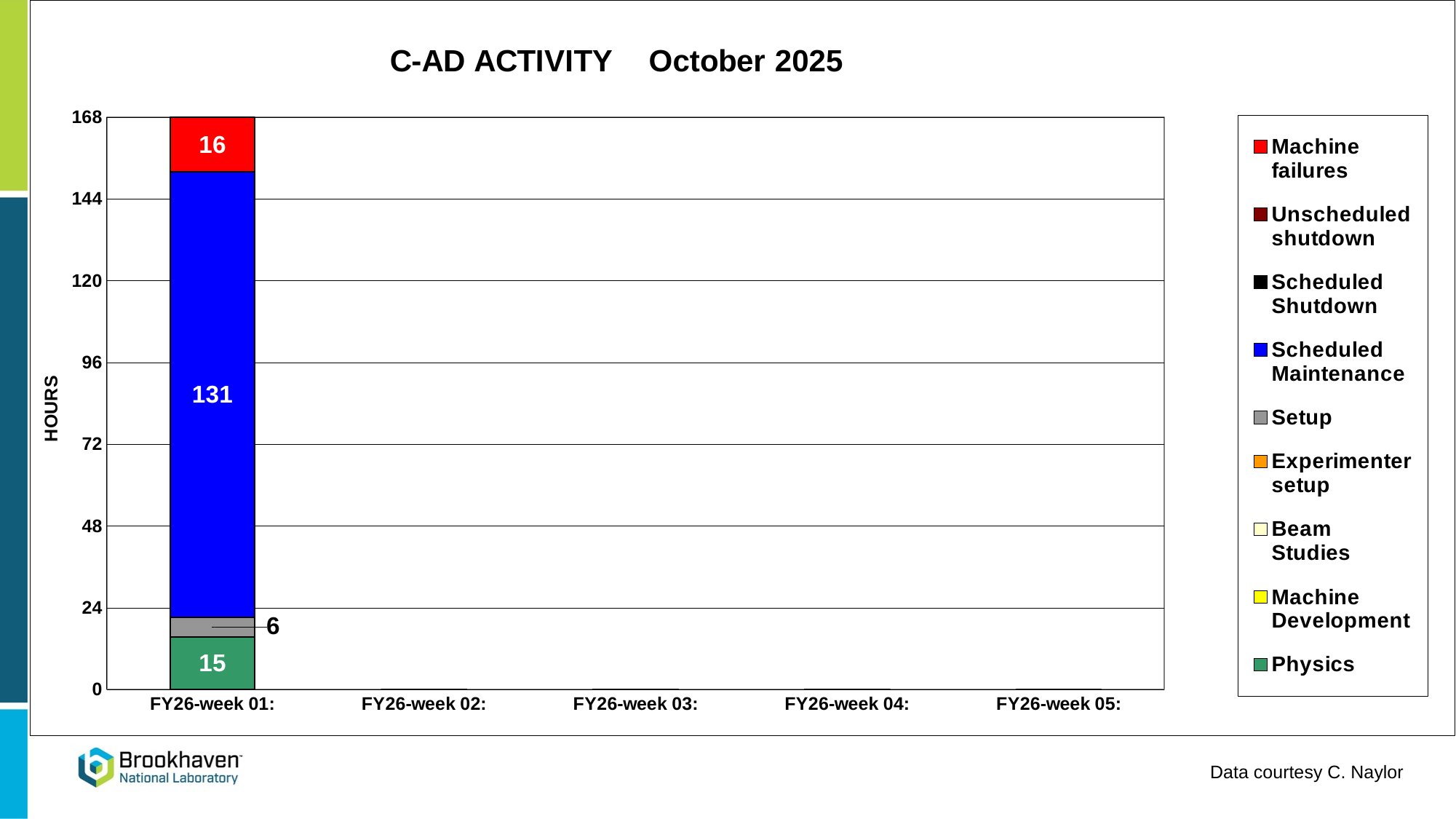
Which activity has the largest number of hours in FY26-week 01? Scheduled Maintenance What is the difference in hours between Scheduled Maintenance and Machine failures in FY26-week 01? 115 How many hours of Setup are shown for FY26-week 01? 6 How many hours of Scheduled Maintenance are shown for FY26-week 01? 131 Which activity has the smallest number of hours in FY26-week 01 among those with a labelled segment? Setup What kind of chart is shown on the slide? stacked bar chart How many hours of Machine failures are shown for FY26-week 01? 16 Which is larger for FY26-week 01, Machine failures or Physics? Machine failures How many hours of Physics are shown for FY26-week 01? 15 How many week categories are shown on the x axis? 5 How many series does the legend list? 9 What is the total height of the stacked bar for FY26-week 01? 168